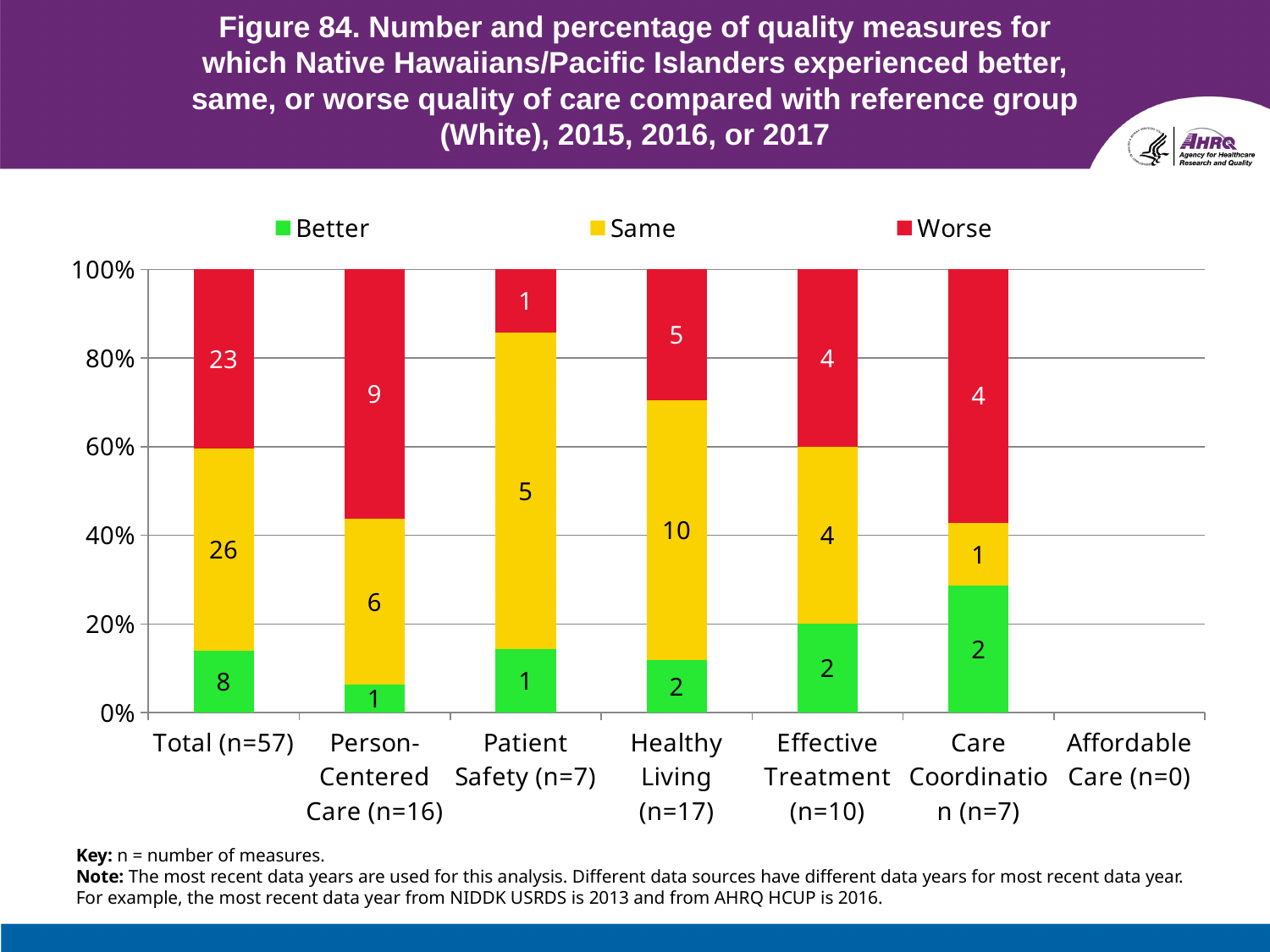
How many series does the legend list? 3 What is the number of measures for which Native Hawaiians/Pacific Islanders experienced worse quality of care in the Total (n=57) category? 23 What is the Worse value for Person-Centered Care (n=16)? 9 For Patient Safety (n=7), is the Same value larger than the Worse value? Yes What is the difference between the Same and Worse values for Total (n=57)? 3 How many categories are shown on the x axis? 7 What kind of chart is shown on the slide? Stacked bar chart Which category has the highest Same value? Total (n=57) What is the total of the Better, Same, and Worse values for Effective Treatment (n=10)? 10 How many Healthy Living measures fall in the Same category? 10 Is the Better share of the Care Coordination (n=7) bar greater or less than 20%? greater What is the Better value for Care Coordination (n=7)? 2